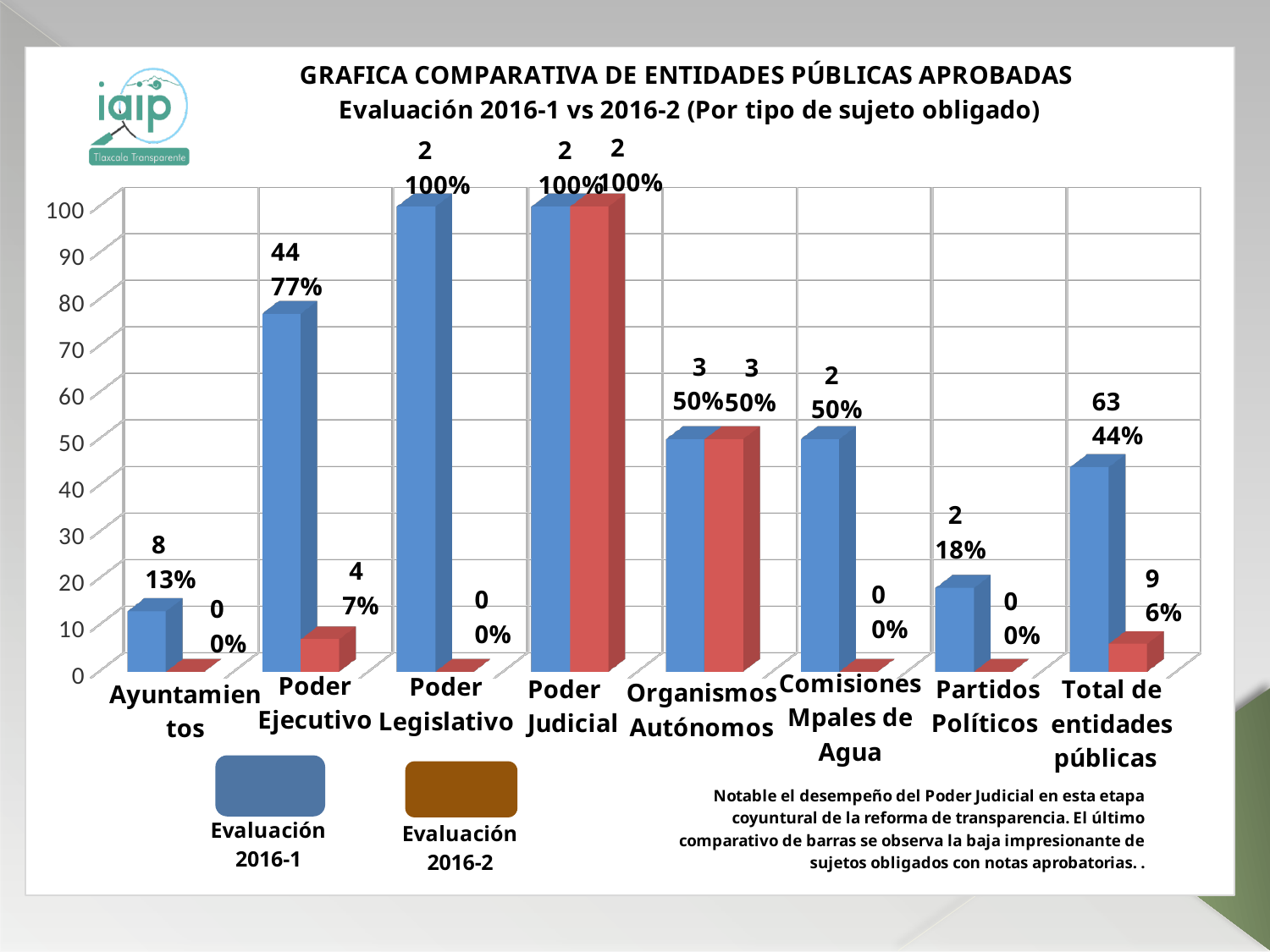
Which category has the lowest percentage in Evaluación 2016-1? Ayuntamientos What percentage is shown for Poder Ejecutivo in Evaluación 2016-1? 77% Which is larger for Ayuntamientos: the Evaluación 2016-1 percentage or the Evaluación 2016-2 percentage? Evaluación 2016-1 How many series does the legend list? 2 What is the difference in percentage points between Evaluación 2016-1 and Evaluación 2016-2 for Poder Ejecutivo? 70 What kind of chart is shown on the slide? Bar chart What percentage is shown for Total de entidades públicas in Evaluación 2016-2? 6% What percentage is shown for Partidos Políticos in Evaluación 2016-1? 18% How many categories are shown on the x axis? 8 What percentage is shown for Poder Ejecutivo in Evaluación 2016-2? 7% Which category has the highest percentage in Evaluación 2016-2? Poder Judicial Which colour represents Evaluación 2016-1 in the chart? Blue